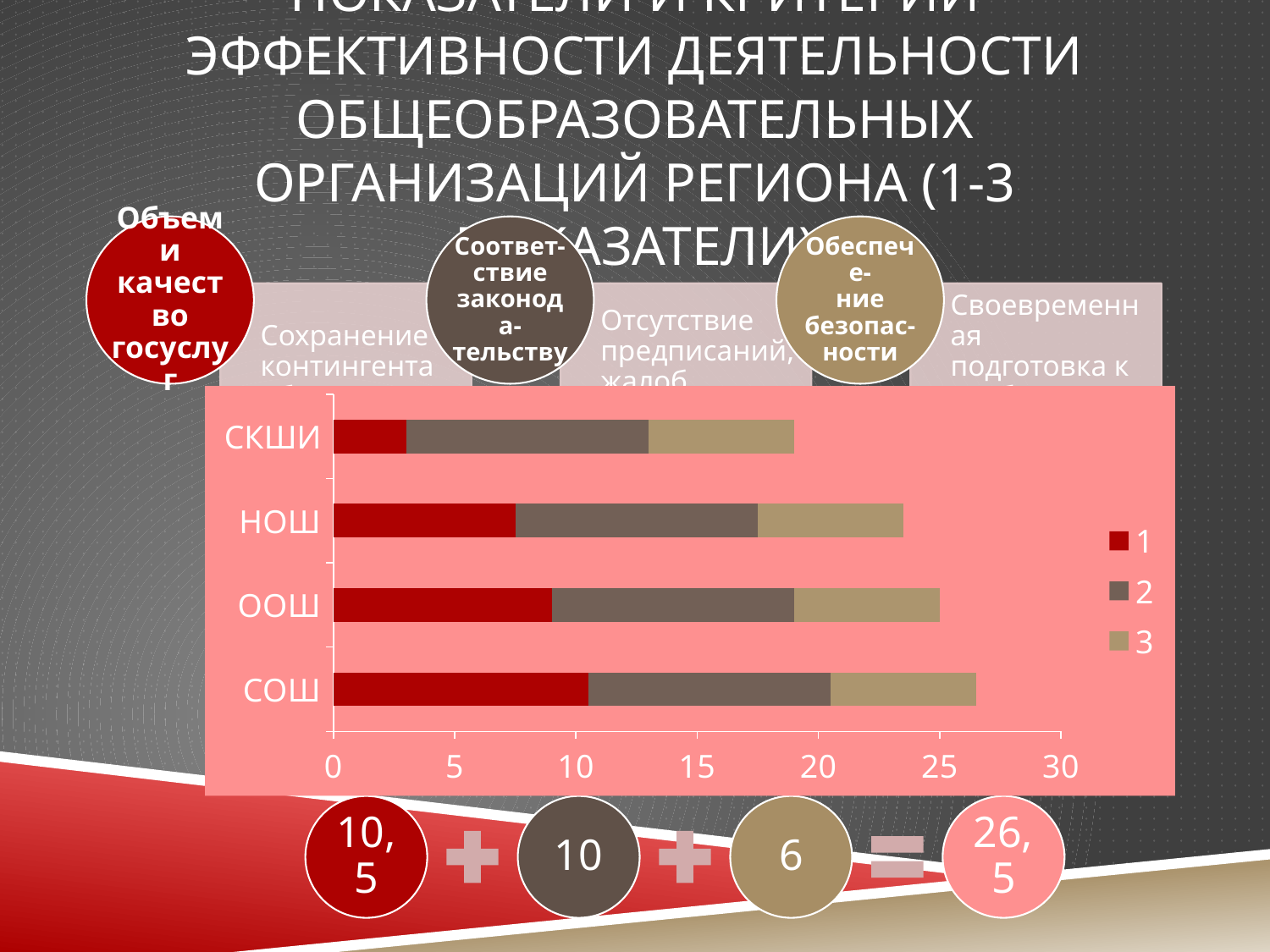
Is the value of series 1 for СКШИ greater or less than 5? less Which has the larger total stacked bar, НОШ or СКШИ? НОШ Is the total stacked bar for СОШ greater or less than 25? greater Is the total stacked bar for СКШИ greater or less than 20? less What kind of chart is shown on the slide? bar chart Which category has the larger value for series 1, СКШИ or СОШ? СОШ What are the entries listed in the chart legend? 1, 2, 3 Which category has the longest total stacked bar? СОШ How many series does the chart legend list? 3 Which category has the shortest total stacked bar? СКШИ How many categories are plotted on the chart's vertical axis? 4